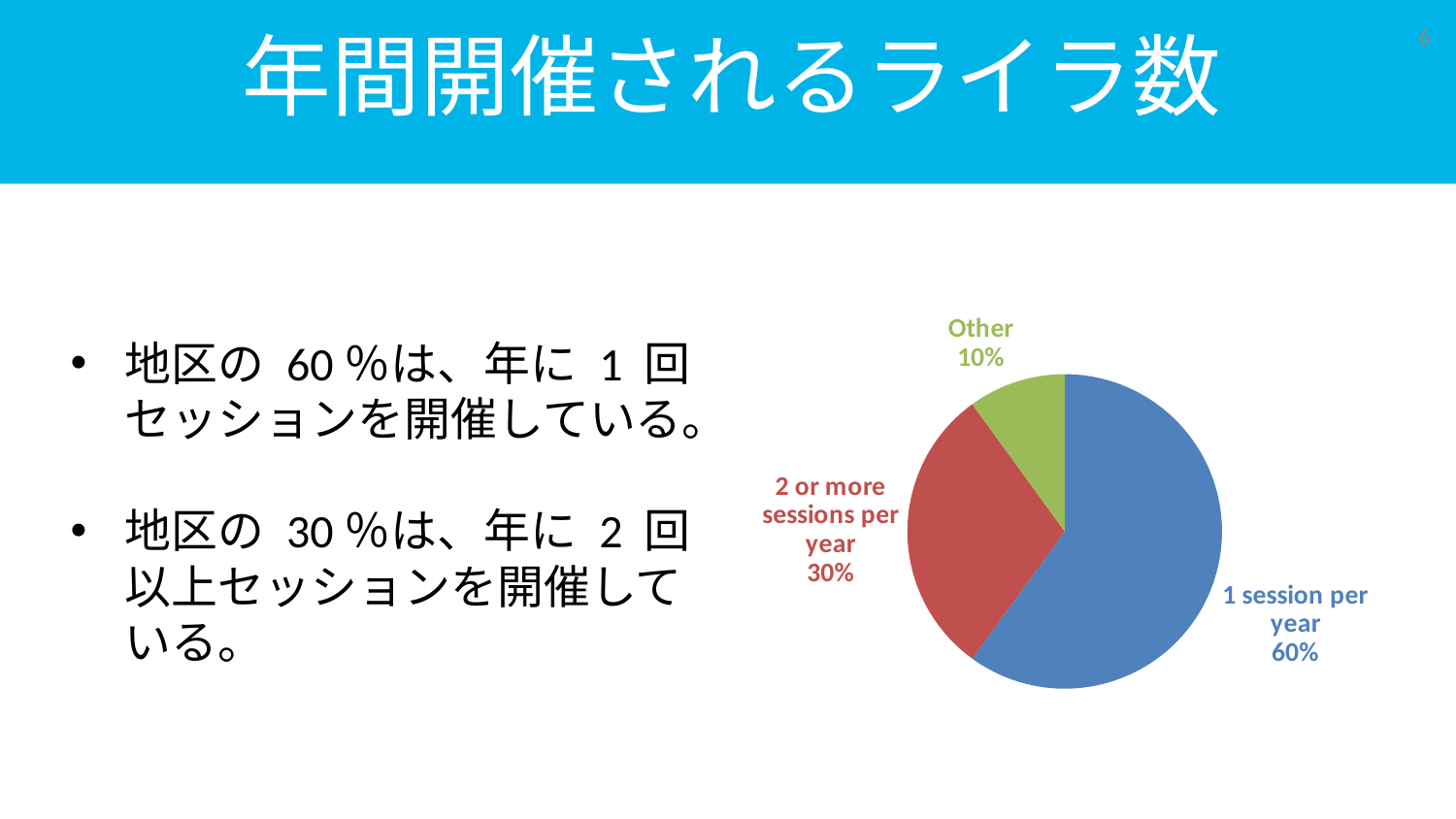
What share of the pie is labelled "2 or more sessions per year"? 30% What colour is the "1 session per year" slice? blue Which is larger: the "2 or more sessions per year" slice or the "Other" slice? 2 or more sessions per year What share of the pie is labelled "Other"? 10% How many slices does the pie chart have? 3 Which slice of the pie chart is the largest? 1 session per year What kind of chart is shown on the slide? pie chart What share of the pie is labelled "1 session per year"? 60% What is the difference in percentage points between the "1 session per year" slice and the "2 or more sessions per year" slice? 30% Which slice of the pie chart is the smallest? Other What is the difference in percentage points between the "2 or more sessions per year" slice and the "Other" slice? 20% What colour is the "Other" slice? green